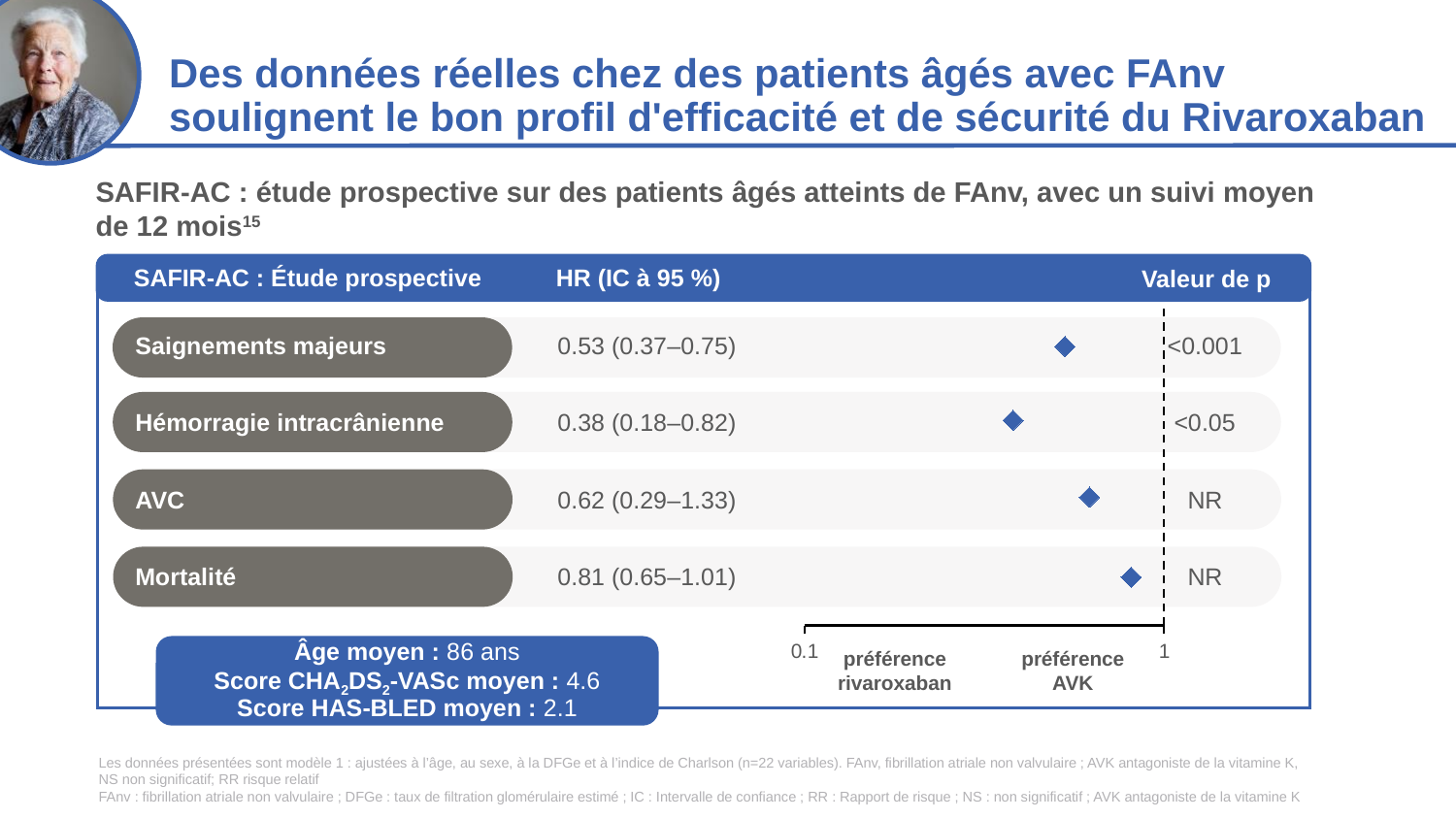
What is the HR (95% CI) shown for AVC? 0.62 (0.29–1.33) What is the HR (95% CI) shown for Hémorragie intracrânienne? 0.38 (0.18–0.82) Which has the larger hazard ratio, AVC or Saignements majeurs? AVC Which outcome has the highest hazard ratio? Mortalité What p-value is shown for Saignements majeurs? <0.001 Which outcome has the lowest hazard ratio? Hémorragie intracrânienne How many outcomes are plotted in the forest plot? 4 Is the hazard ratio point estimate for Mortalité greater or less than 1? less What kind of chart is shown on the slide? Forest plot What p-value is shown for Mortalité? NR What is the HR (95% CI) shown for Saignements majeurs? 0.53 (0.37–0.75) What is the difference between the hazard ratio for Mortalité and the hazard ratio for Hémorragie intracrânienne? 0.43